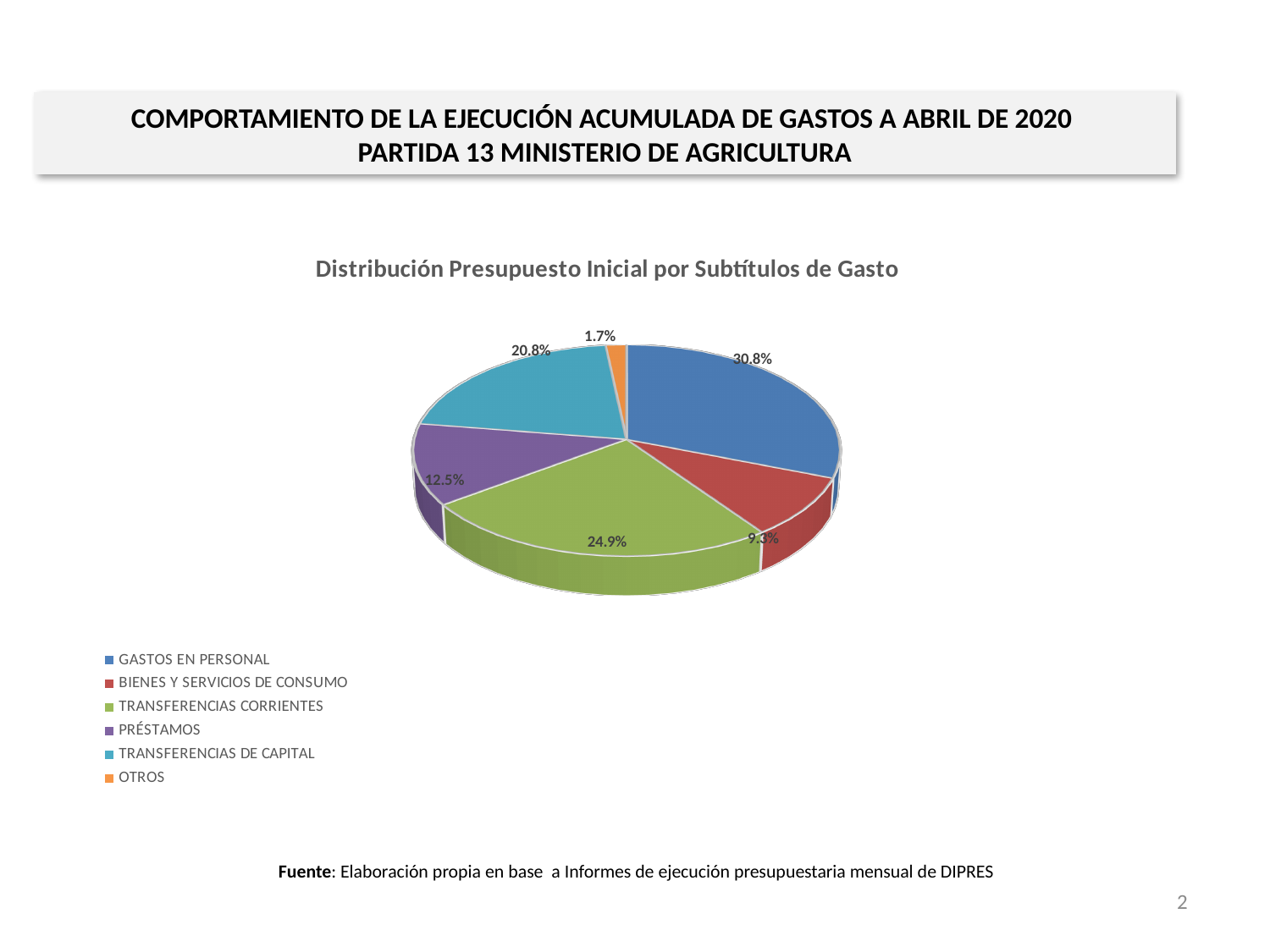
What share of the pie does GASTOS EN PERSONAL represent? 30.8% What is the difference in percentage points between GASTOS EN PERSONAL and TRANSFERENCIAS CORRIENTES? 5.9 What share of the pie does TRANSFERENCIAS DE CAPITAL represent? 20.8% What share of the pie does TRANSFERENCIAS CORRIENTES represent? 24.9% What kind of chart is shown on the slide? pie chart What share of the pie does PRÉSTAMOS represent? 12.5% What share of the pie does OTROS represent? 1.7% How many categories does the legend list? 6 Which is larger, the share for TRANSFERENCIAS DE CAPITAL or the share for PRÉSTAMOS? TRANSFERENCIAS DE CAPITAL Which category has the smallest share of the pie? OTROS What is the title of the chart? Distribución Presupuesto Inicial por Subtítulos de Gasto Which category has the largest share of the pie? GASTOS EN PERSONAL